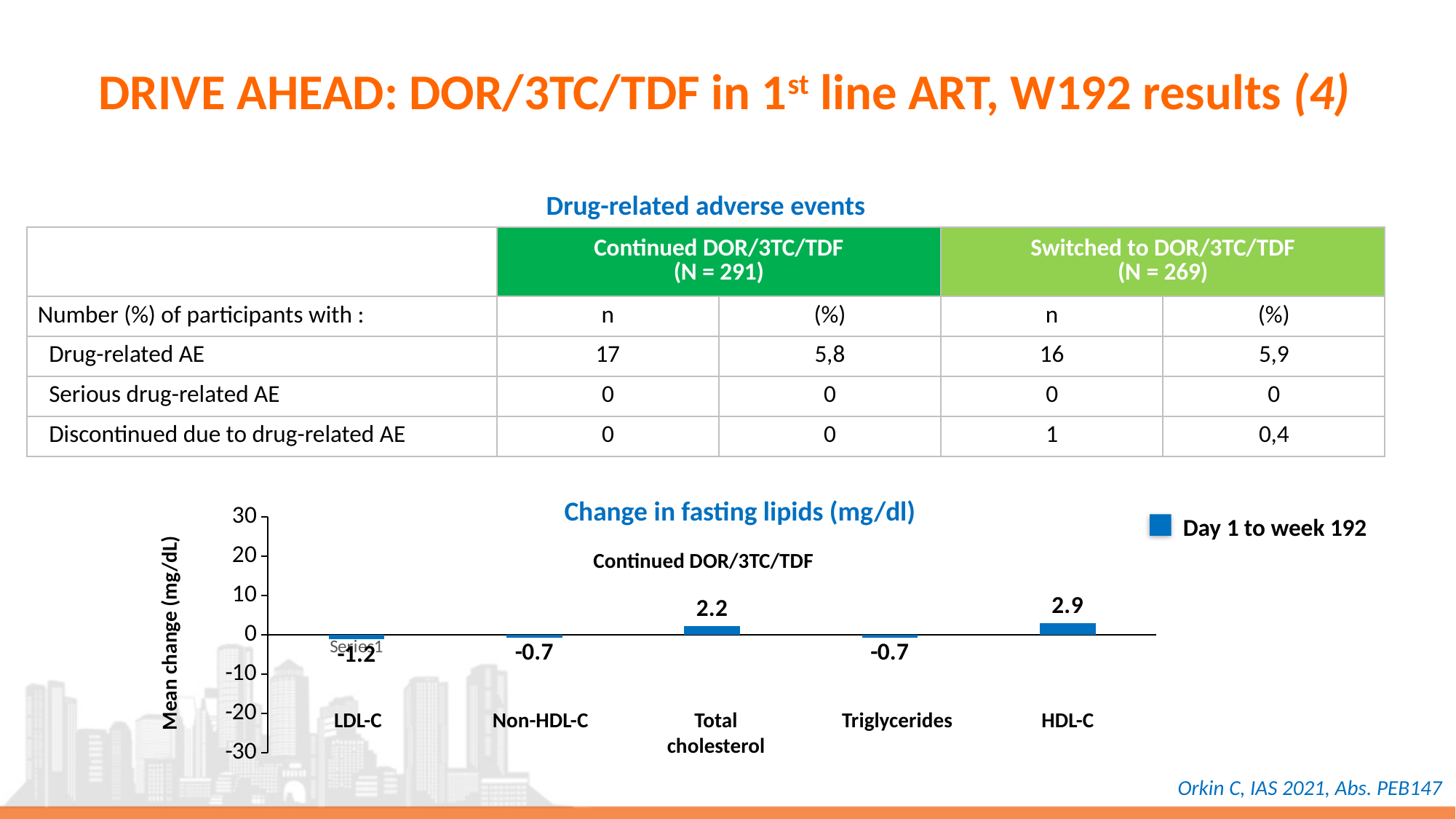
How many series does the chart legend list? 1 Which has a larger mean change, Total cholesterol or Non-HDL-C? Total cholesterol What is the mean change in LDL-C from Day 1 to week 192? -1.2 What is the mean change in HDL-C from Day 1 to week 192? 2.9 Which lipid parameter shows the lowest mean change? LDL-C What is the difference between the mean change for HDL-C and Total cholesterol? 0.7 What is the mean change in Triglycerides from Day 1 to week 192? -0.7 What is the mean change in Total cholesterol from Day 1 to week 192? 2.2 Which lipid parameter shows the largest mean change? HDL-C What is the title of the chart? Change in fasting lipids (mg/dl) How many lipid parameters are plotted in the chart? 5 What type of chart is used to show the change in fasting lipids? Bar chart